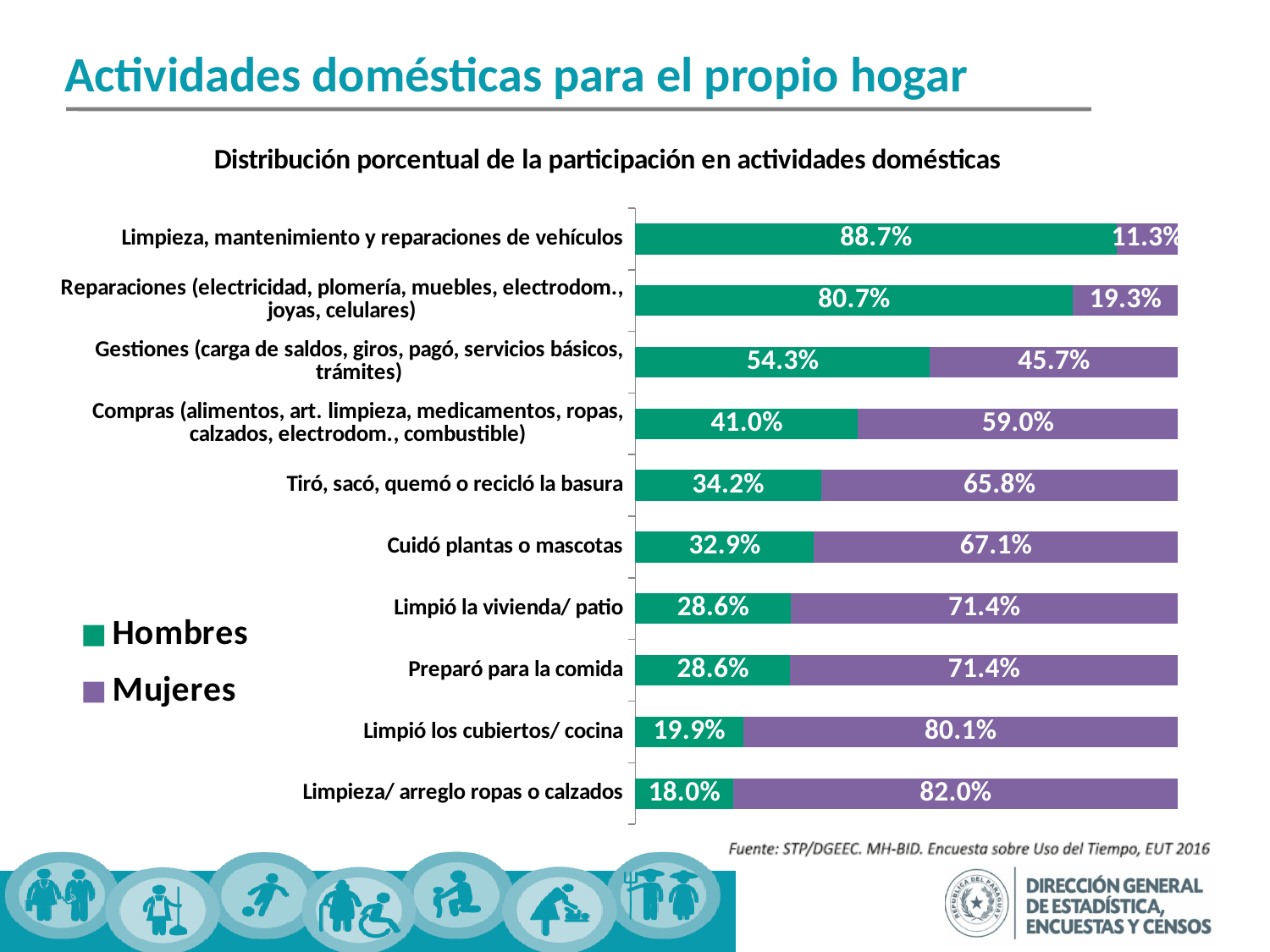
Which category has the lowest Hombres value? Limpieza/ arreglo ropas o calzados Which colour represents Mujeres in the chart? Purple What is the difference between the Mujeres and Hombres values for "Tiró, sacó, quemó o recicló la basura"? 31.6% How many series does the legend list? 2 What is the Mujeres value for "Limpió los cubiertos/ cocina"? 80.1% How many categories are shown on the chart? 10 What is the Hombres value for "Limpieza, mantenimiento y reparaciones de vehículos"? 88.7% What kind of chart is shown on the slide? Stacked bar chart Which is larger for "Gestiones (carga de saldos, giros, pagó, servicios básicos, trámites)": the Hombres value or the Mujeres value? Hombres Which category has the highest Mujeres value? Limpieza/ arreglo ropas o calzados What is the Hombres value for "Cuidó plantas o mascotas"? 32.9% What is the total of the stacked bar for "Preparó para la comida"? 100.0%